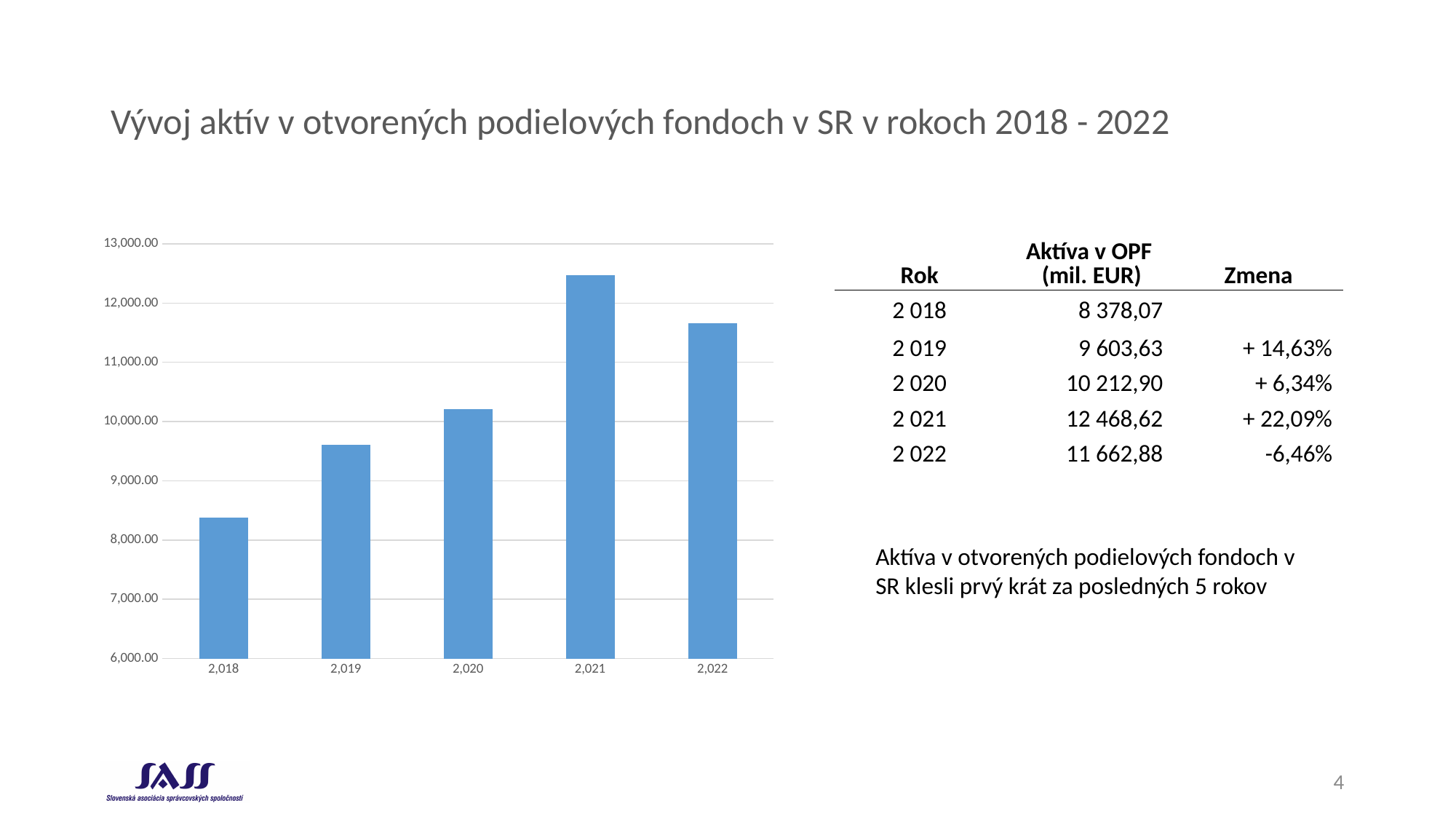
Is the value for 2022 greater or less than 12,000.00? less According to the table on the slide, what is the value of assets in OPF (mil. EUR) for 2021? 12 468,62 How many bars (years) does the chart show? 5 What kind of chart is shown on the slide? bar chart Do the bars rise or fall from 2018 to 2021? rise Is the value for 2020 greater or less than 10,000.00? greater Which is larger, the bar for 2019 or the bar for 2022? 2022 Is the value for 2021 greater or less than 12,000.00? greater According to the table on the slide, what is the value of assets in OPF (mil. EUR) for 2022? 11 662,88 Which year has the highest bar in the chart? 2021 Which year has the lowest bar in the chart? 2018